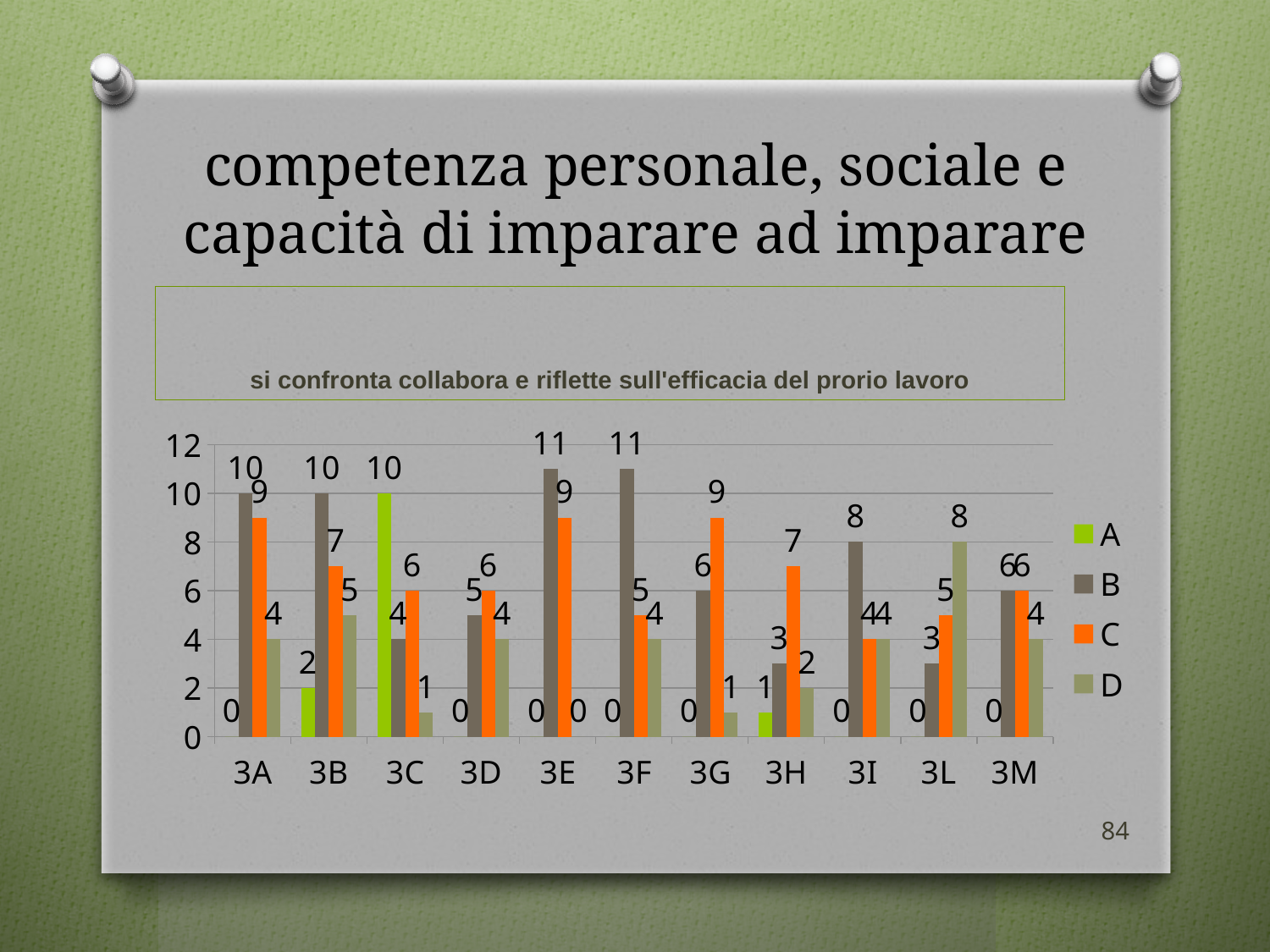
How many series does the legend list? 4 What is the value of series A for category 3C? 10 Which category has the lowest value for series C? 3I What is the value of series D for category 3L? 8 What is the difference between series B and series C for category 3B? 3 What is the value of series C for category 3H? 7 How many categories are shown on the x axis? 11 Which category has the highest value for series D? 3L What kind of chart is shown on the slide? bar chart For category 3G, which is larger: series B or series C? C What is the title of the chart? si confronta collabora e riflette sull'efficacia del prorio lavoro What is the value of series B for category 3E? 11